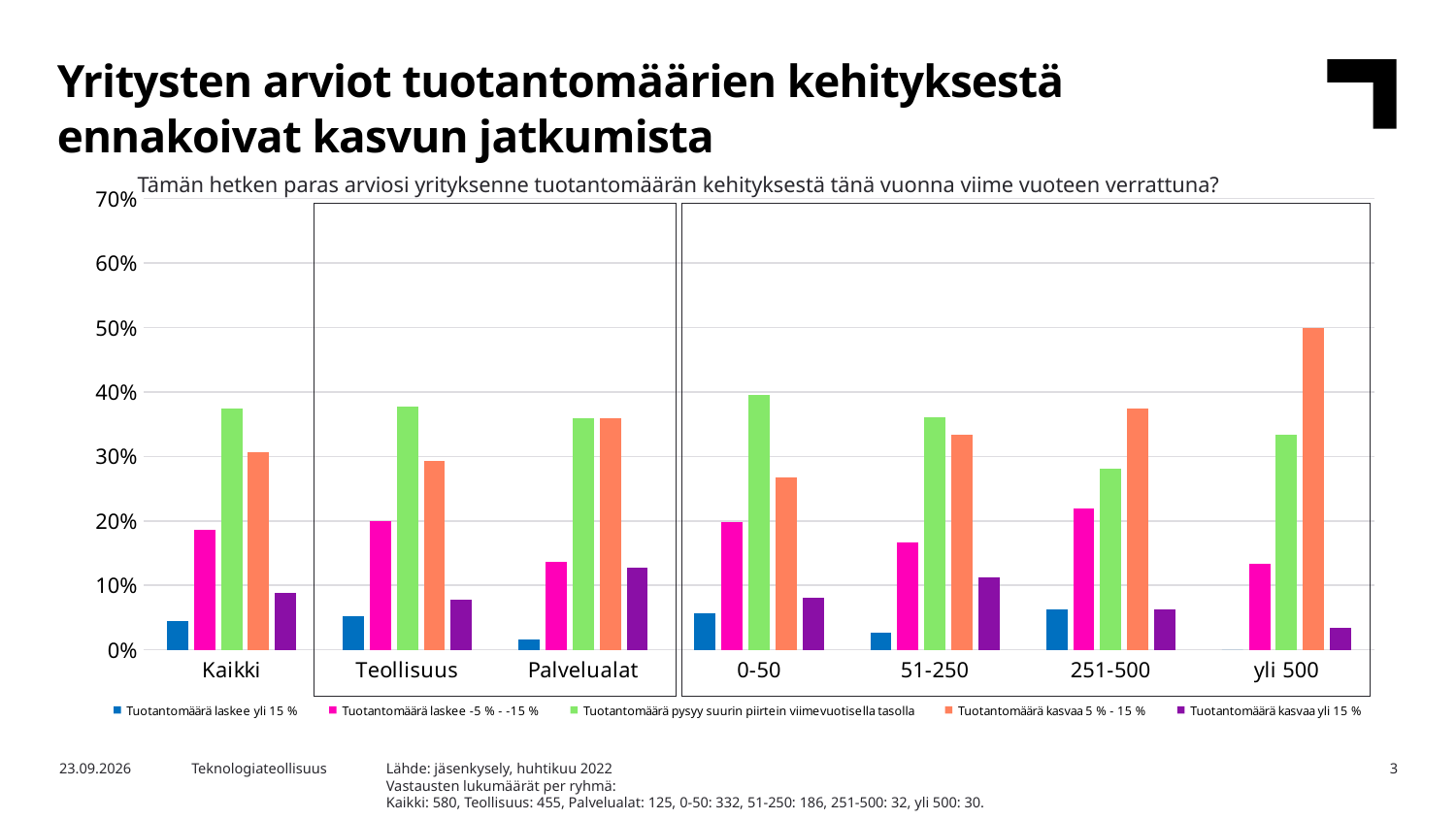
Is the value of 'Tuotantomäärä laskee yli 15 %' for 'Palvelualat' greater or less than 10%? less Is the value of 'Tuotantomäärä kasvaa yli 15 %' for 'Palvelualat' greater or less than 10%? greater Which category has the highest value for 'Tuotantomäärä kasvaa 5 % - 15 %'? yli 500 For '251-500', which is larger: 'Tuotantomäärä pysyy suurin piirtein viimevuotisella tasolla' or 'Tuotantomäärä kasvaa 5 % - 15 %'? Tuotantomäärä kasvaa 5 % - 15 % Which has the larger value for 'Tuotantomäärä laskee -5 % - -15 %': 'Kaikki' or 'Palvelualat'? Kaikki What kind of chart is shown on the slide? bar chart How many categories are shown along the x axis of the chart? 7 Is the value of 'Tuotantomäärä pysyy suurin piirtein viimevuotisella tasolla' for '0-50' greater or less than 30%? greater What question is shown as the chart's title above the plot area? Tämän hetken paras arviosi yrityksenne tuotantomäärän kehityksestä tänä vuonna viime vuoteen verrattuna? How many series does the chart's legend list? 5 For 'Kaikki', which is larger: 'Tuotantomäärä pysyy suurin piirtein viimevuotisella tasolla' or 'Tuotantomäärä kasvaa 5 % - 15 %'? Tuotantomäärä pysyy suurin piirtein viimevuotisella tasolla